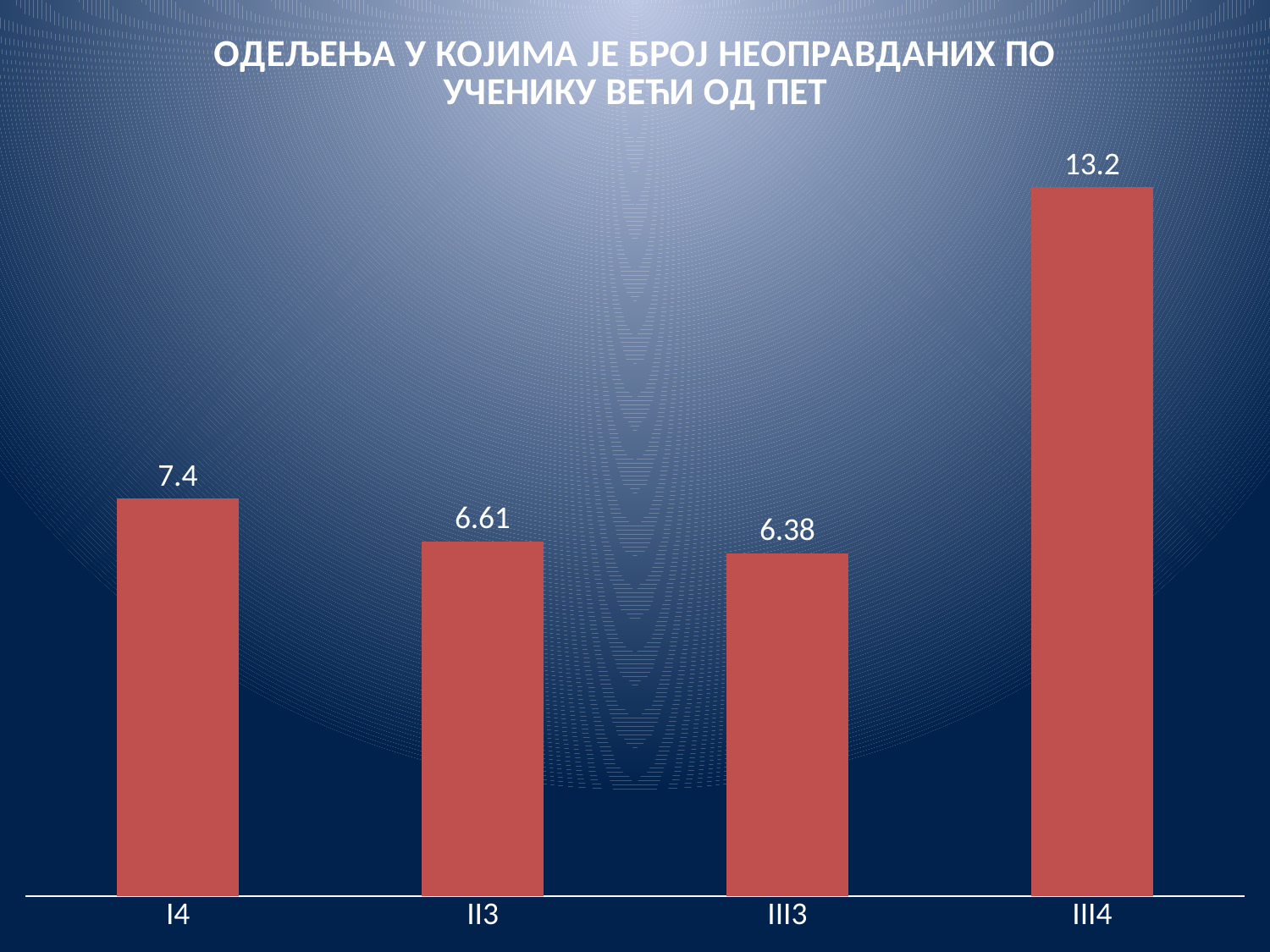
How many categories are shown on the x axis? 4 What is the difference between the values for III4 and I4? 5.8 What is the value for III4? 13.2 What colour are the bars in the chart? red Which category has the highest value? III4 Which is larger, the value for I4 or the value for II3? I4 What is the value for III3? 6.38 What is the value for II3? 6.61 What is the difference between the values for II3 and III3? 0.23 Which category has the lowest value? III3 What kind of chart is shown on the slide? bar chart What is the value for I4? 7.4